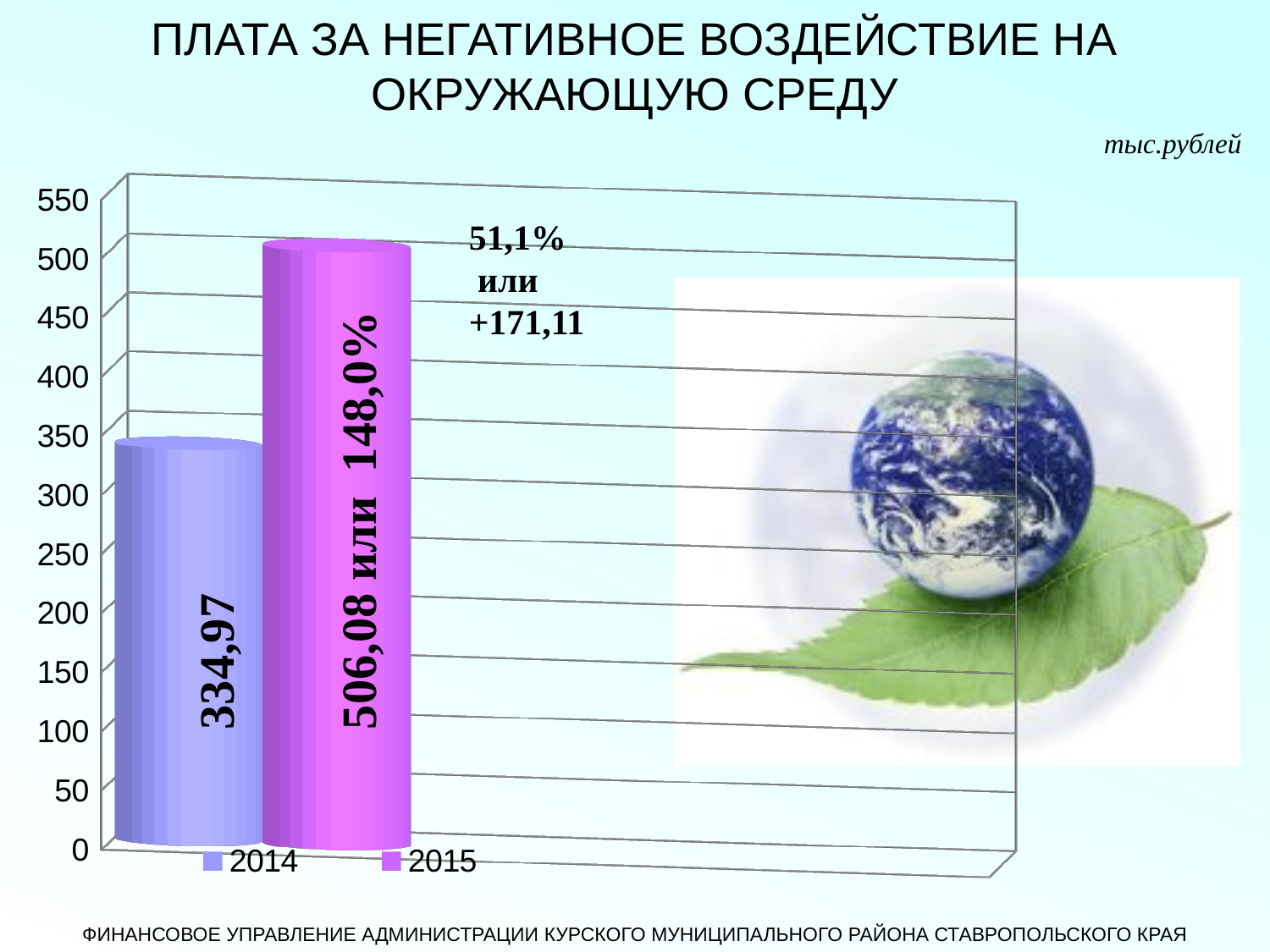
Which year has the higher value? 2015 What is the difference between the 2015 value and the 2014 value? 171,11 How many bars are plotted on the chart? 2 How many entries does the legend list? 2 Do the values rise or fall from 2014 to 2015? rise What unit of measurement is indicated above the chart? тыс.рублей What is the value for 2014? 334,97 Which year has the lower value? 2014 What is the value for 2015? 506,08 Is the value for 2014 greater or less than 350? less Is the value for 2015 greater or less than 500? greater What kind of chart is shown on the slide? bar chart